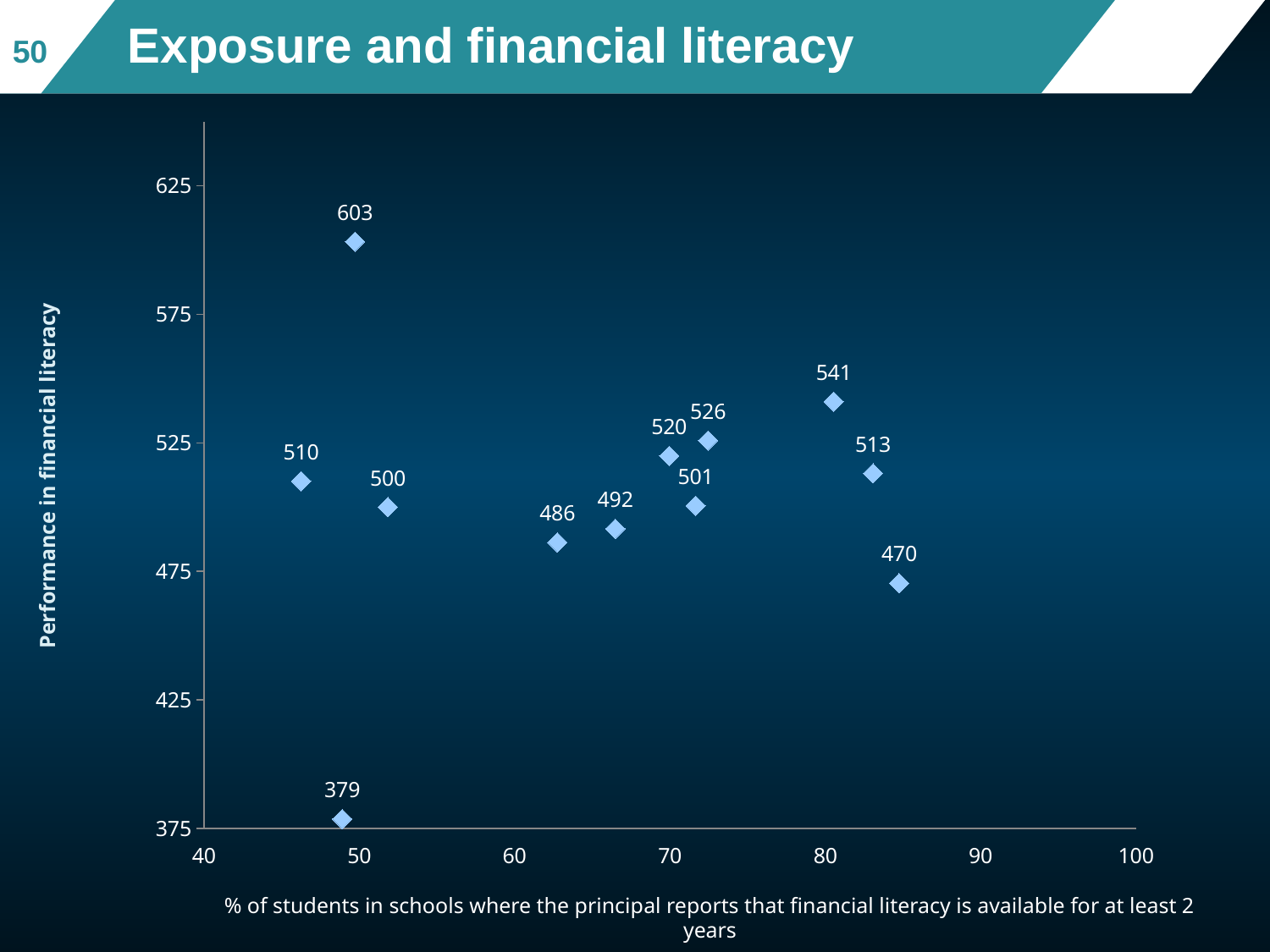
What is the difference between the performance values of the points labeled 541 and 513? 28 How many data points are plotted on the chart? 12 What kind of chart is shown on the slide? scatter chart What is the difference between the highest and lowest labeled performance values on the chart? 224 Is the x-axis value (% of students) for the point labeled 470 greater or less than 80? greater Which is larger, the performance value of the point labeled 541 or the point labeled 526? 541 What is the lowest performance in financial literacy value labeled on the chart? 379 What is the highest performance in financial literacy value labeled on the chart? 603 Is the x-axis value (% of students) for the point labeled 603 greater or less than 60? less Is the x-axis value (% of students) for the point labeled 541 greater or less than 70? greater What is the performance value of the leftmost point on the chart (the one with the smallest x-axis value)? 510 What is the title of the vertical axis of the chart? Performance in financial literacy